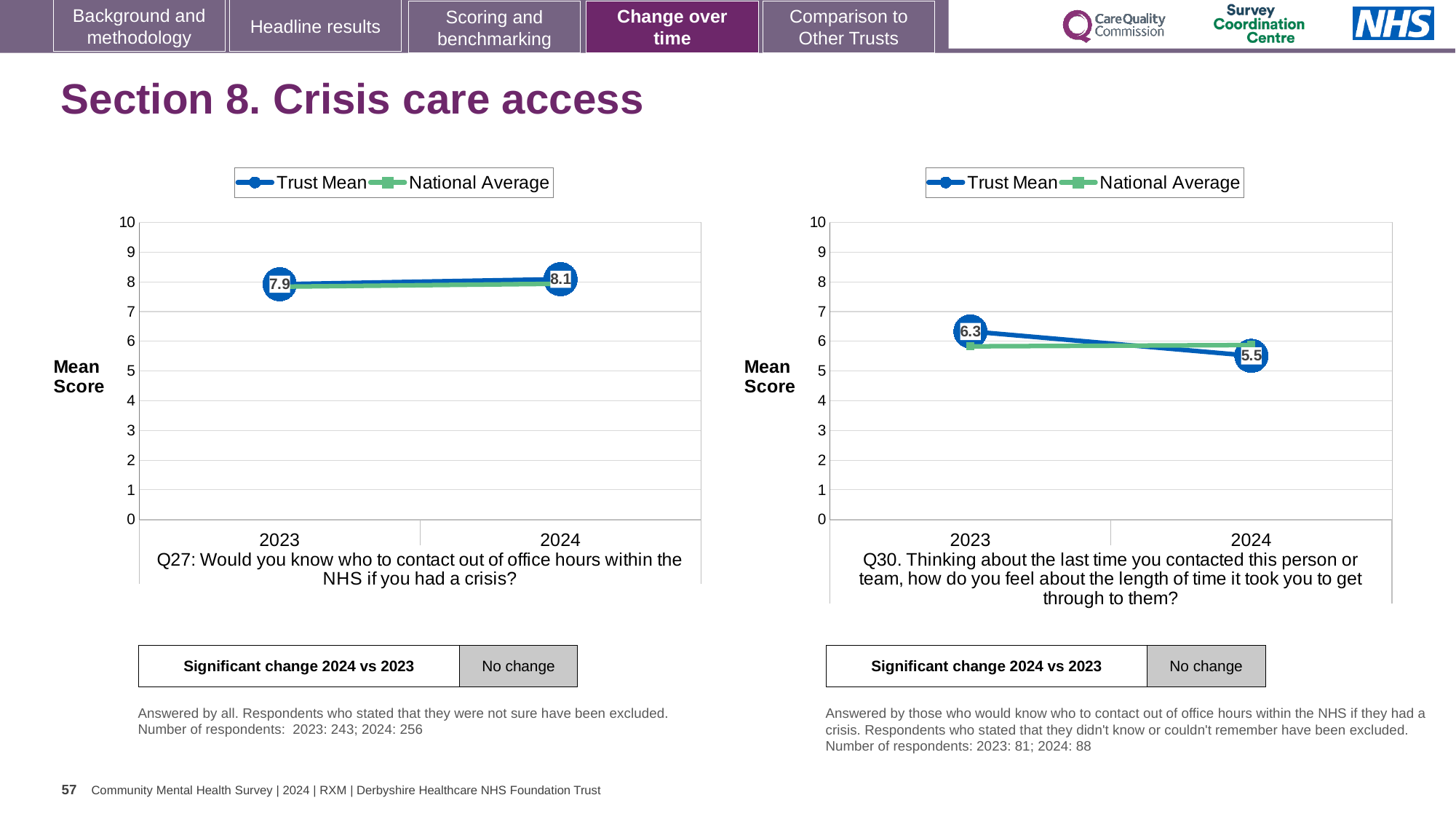
In the left chart (Q27), what is the Trust Mean score for 2023? 7.9 In the left chart (Q27), what is the difference between the Trust Mean scores for 2024 and 2023? 0.2 In the left chart (Q27), what is the Trust Mean score for 2024? 8.1 In the right chart (Q30), is the Trust Mean for 2023 greater or less than the Trust Mean for 2024? greater How many series does the legend of the left chart (Q27) list? 2 In the right chart (Q30), is the National Average value for 2024 greater or less than 5? greater In the right chart (Q30), what is the Trust Mean score for 2024? 5.5 What type of chart is used for Q30 on the right of the slide? line chart In the right chart (Q30), what is the Trust Mean score for 2023? 6.3 In the left chart (Q27), does the Trust Mean rise or fall from 2023 to 2024? rise In the right chart (Q30), what is the difference between the Trust Mean scores for 2023 and 2024? 0.8 In the right chart (Q30), does the Trust Mean rise or fall from 2023 to 2024? fall